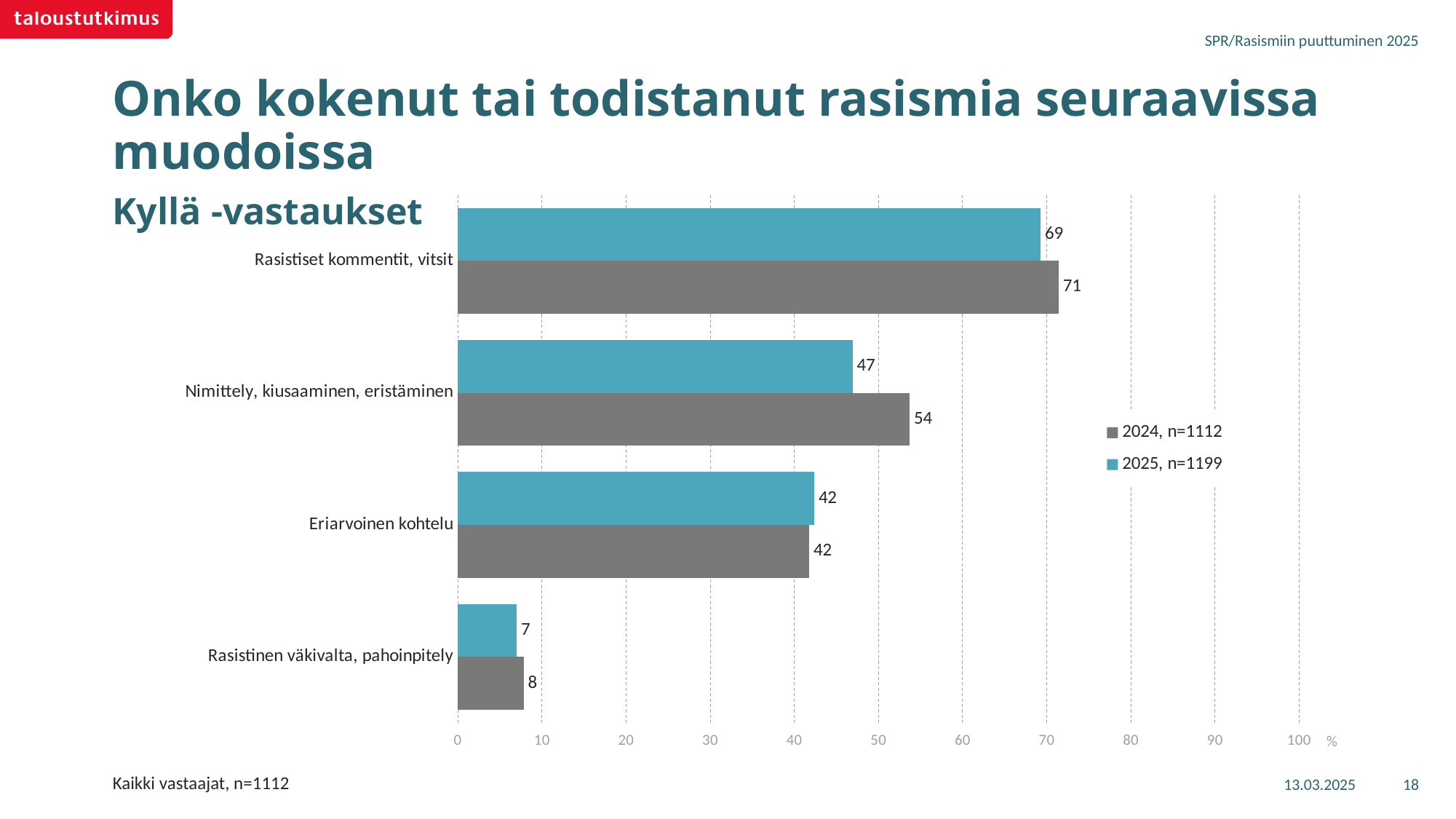
How many categories are shown on the chart? 4 What is the value for "Rasistinen väkivalta, pahoinpitely" in the 2025, n=1199 series? 7 Which category has the highest value in the 2024, n=1112 series? Rasistiset kommentit, vitsit For "Rasistiset kommentit, vitsit", which series has the larger value, 2024, n=1112 or 2025, n=1199? 2024, n=1112 How many series does the legend list? 2 What is the value for "Nimittely, kiusaaminen, eristäminen" in the 2024, n=1112 series? 54 What is the value for "Eriarvoinen kohtelu" in the 2024, n=1112 series? 42 What colour are the bars for the 2025, n=1199 series? Teal blue What kind of chart is shown on the slide? Bar chart What is the value for "Rasistiset kommentit, vitsit" in the 2025, n=1199 series? 69 What is the difference between the 2024 and 2025 values for "Nimittely, kiusaaminen, eristäminen"? 7 Which category has the lowest value in the 2025, n=1199 series? Rasistinen väkivalta, pahoinpitely